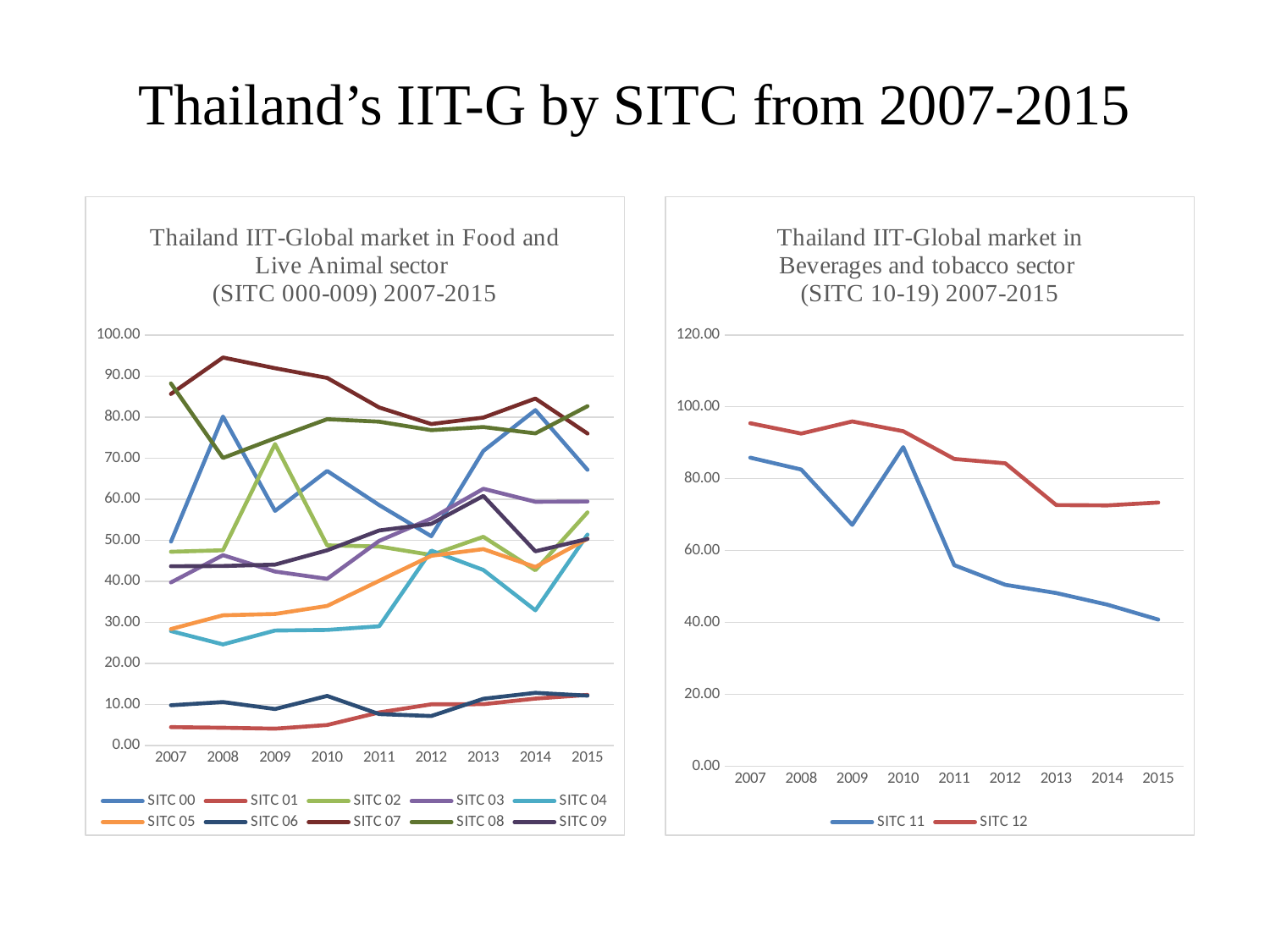
In the right chart (Beverages and tobacco sector), which series has the larger value in 2015, SITC 11 or SITC 12? SITC 12 In the right chart (Beverages and tobacco sector), is the value for SITC 12 in 2007 greater or less than 80? greater How many years are shown on the x axis of the right chart (Beverages and tobacco sector)? 9 In the right chart (Beverages and tobacco sector), does the SITC 11 line overall rise or fall from 2007 to 2015? Fall In the left chart (Food and Live Animal sector), is the value for SITC 04 in 2014 greater or less than 40? less How many series does the legend of the left chart (Food and Live Animal sector) list? 10 What is the title of the right chart? Thailand IIT-Global market in Beverages and tobacco sector (SITC 10-19) 2007-2015 How many series does the legend of the right chart (Beverages and tobacco sector) list? 2 What kind of chart is the left chart, 'Thailand IIT-Global market in Food and Live Animal sector'? Line chart In the left chart (Food and Live Animal sector), which series has the highest value in 2008? SITC 07 In the left chart (Food and Live Animal sector), is the value for SITC 07 in 2008 greater or less than 90? greater